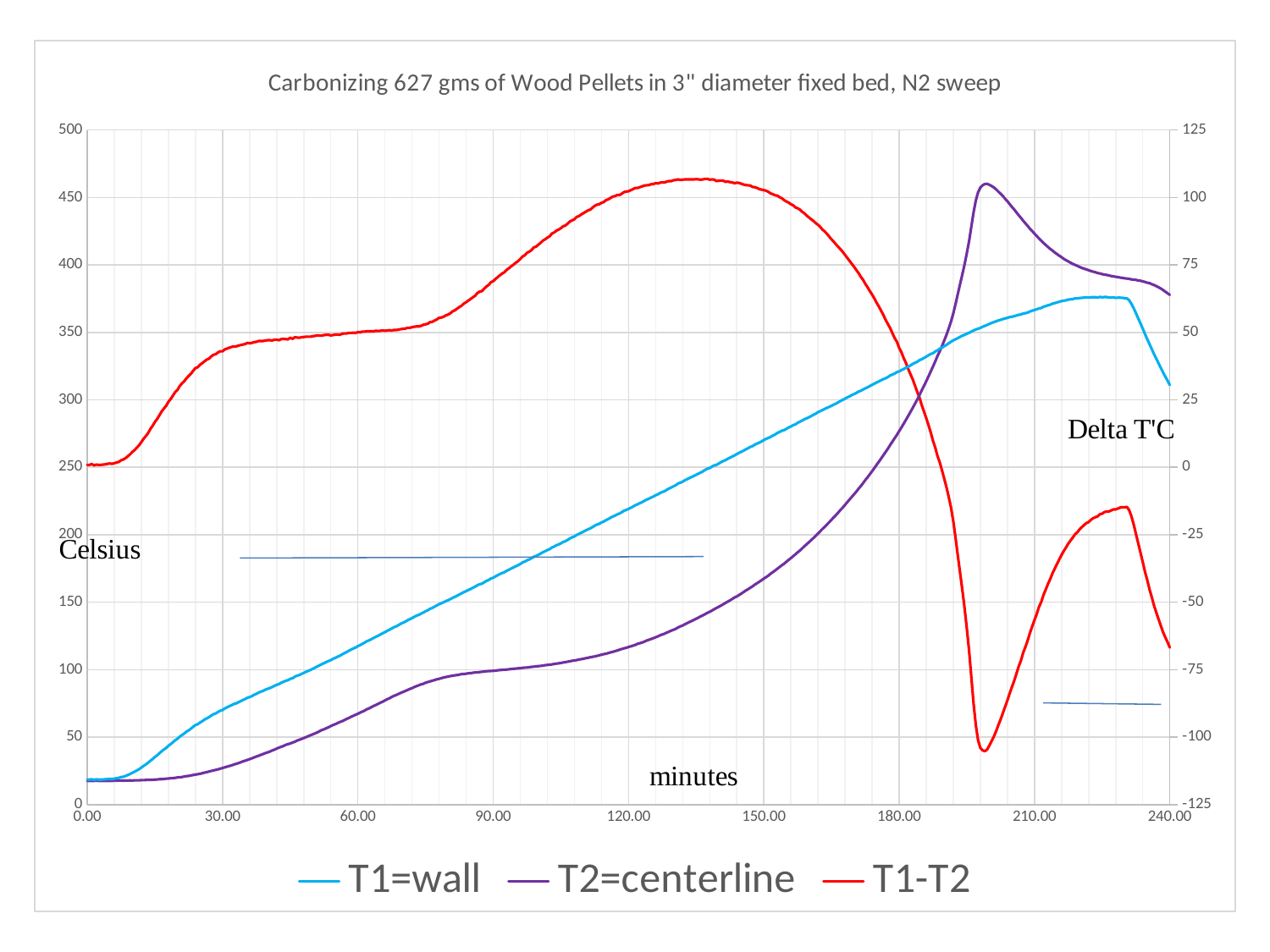
Is the value of T1=wall at 240 minutes greater or less than 350 on the Celsius axis? less Which series reaches the highest value on the Celsius axis? T2=centerline Is the value of T1=wall at 120 minutes greater or less than 200 on the Celsius axis? greater Which colour is used for the T1-T2 series? red How many series does the legend list? 3 What kind of chart is shown on the slide? line chart At 120 minutes, which is higher, T1=wall or T2=centerline? T1=wall At 210 minutes, which is higher, T1=wall or T2=centerline? T2=centerline What is the title of the chart? Carbonizing 627 gms of Wood Pellets in 3" diameter fixed bed, N2 sweep Is the lowest value of T1-T2 greater or less than -75 on the Delta T'C axis? less